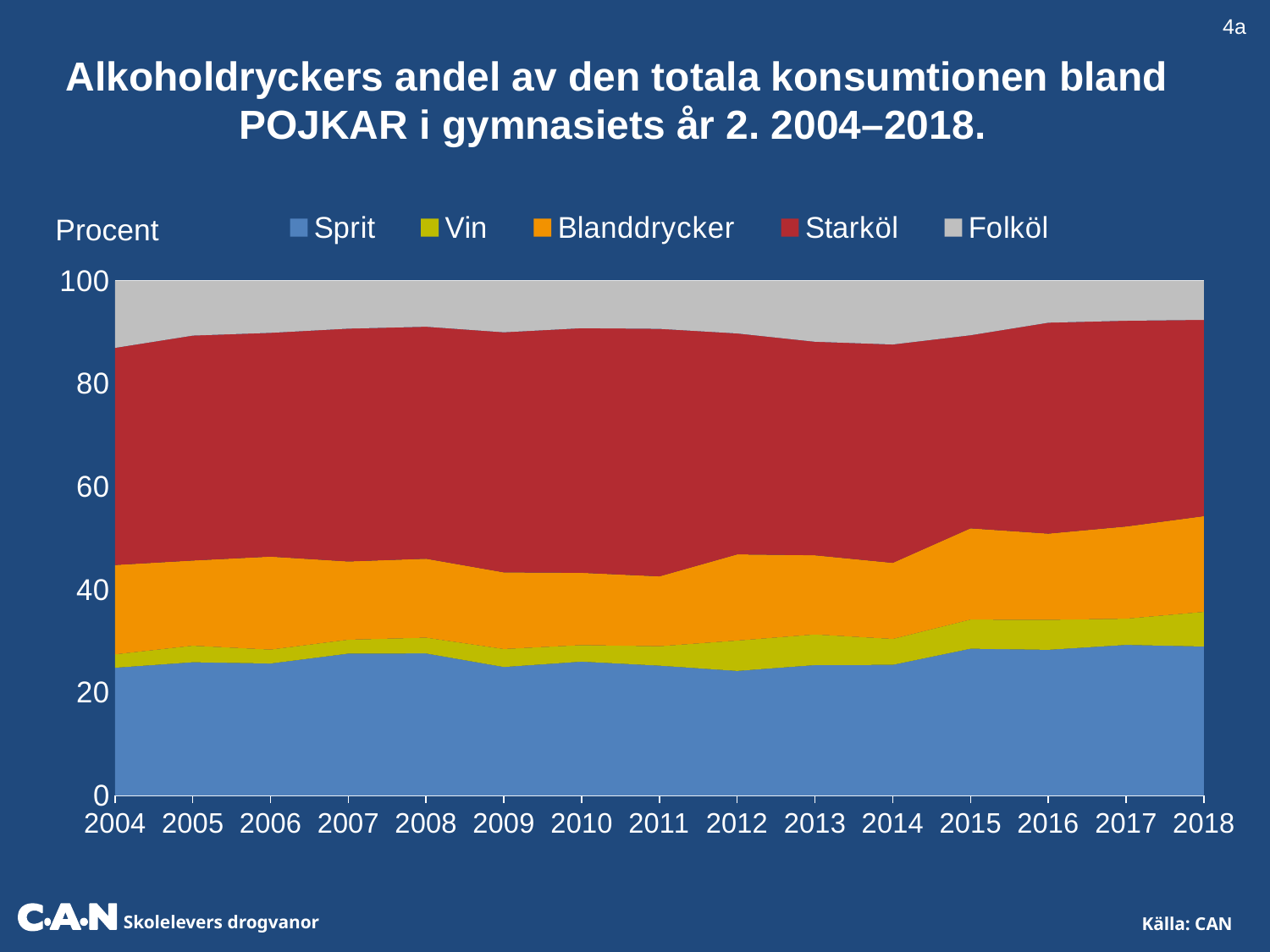
Which series takes up the smallest share of the chart area? Vin What label is shown on the vertical axis? Procent Is the value for Sprit in 2018 greater or less than 20? greater Which series takes up the largest share of the chart area? Starköl Which series has the larger share in 2018, Starköl or Vin? Starköl How many series does the legend list? 5 Is the value for Sprit in 2004 greater or less than 40? less Is the cumulative top of the Blanddrycker band in 2018 greater or less than 60? less Which series is listed first in the legend? Sprit What kind of chart is shown on the slide? Stacked area chart Does the share for Folköl rise or fall from 2004 to 2018? fall How many years are shown along the x axis? 15